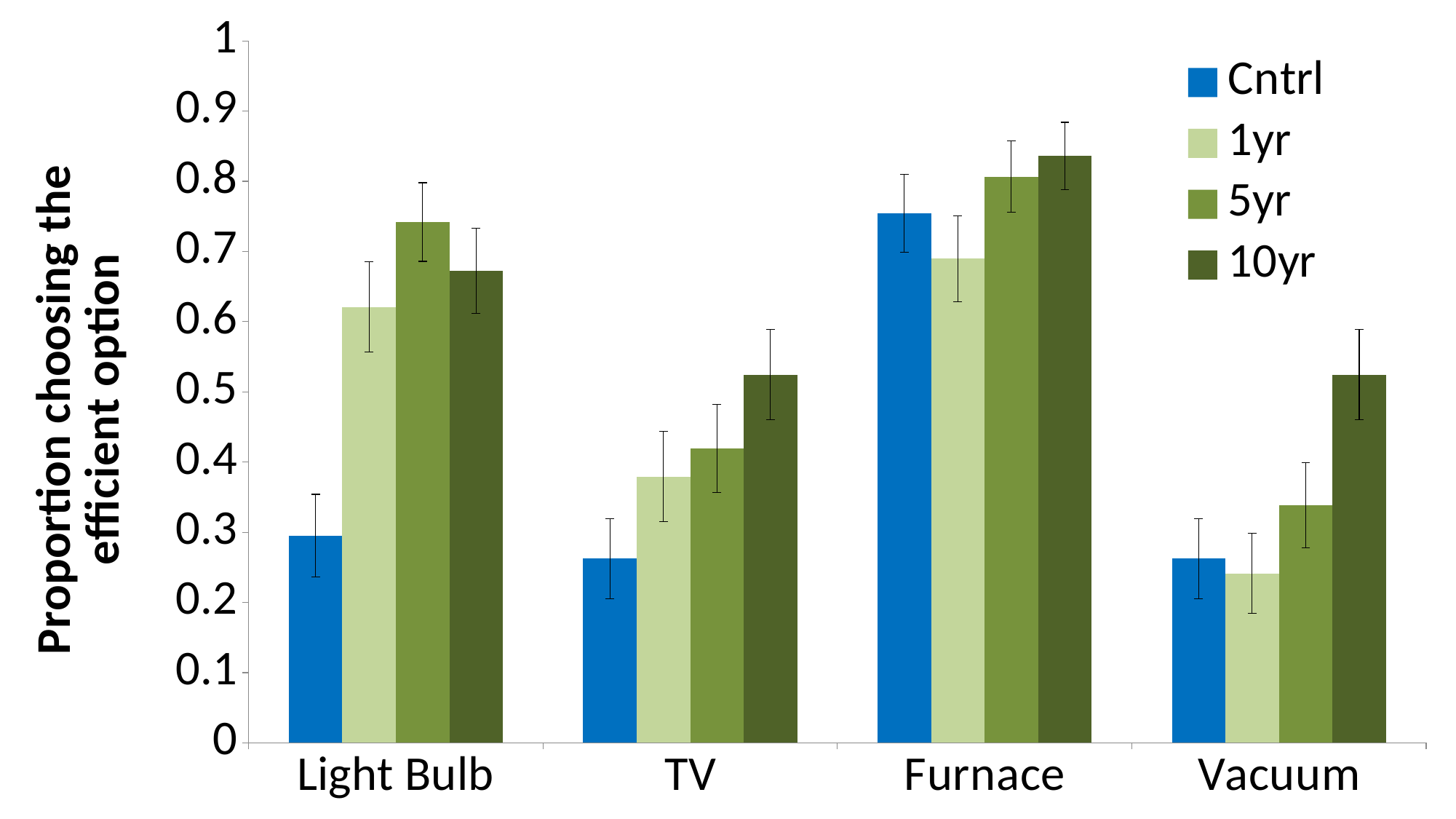
How many series does the legend list? 4 Is the 10yr value for Furnace greater or less than 0.8? greater For TV, do the values rise or fall going from Cntrl to 1yr to 5yr to 10yr? rise Is the Cntrl value for Light Bulb greater or less than 0.4? less What is the title of the y axis? Proportion choosing the efficient option How many product categories are shown on the x axis? 4 What kind of chart is shown on the slide? bar chart Is the 10yr value for TV greater or less than 0.4? greater Which category has the lowest 5yr value? Vacuum For Furnace, which is larger: the Cntrl value or the 1yr value? Cntrl For Light Bulb, which is larger: the 5yr value or the 10yr value? 5yr Which category has the highest Cntrl value? Furnace